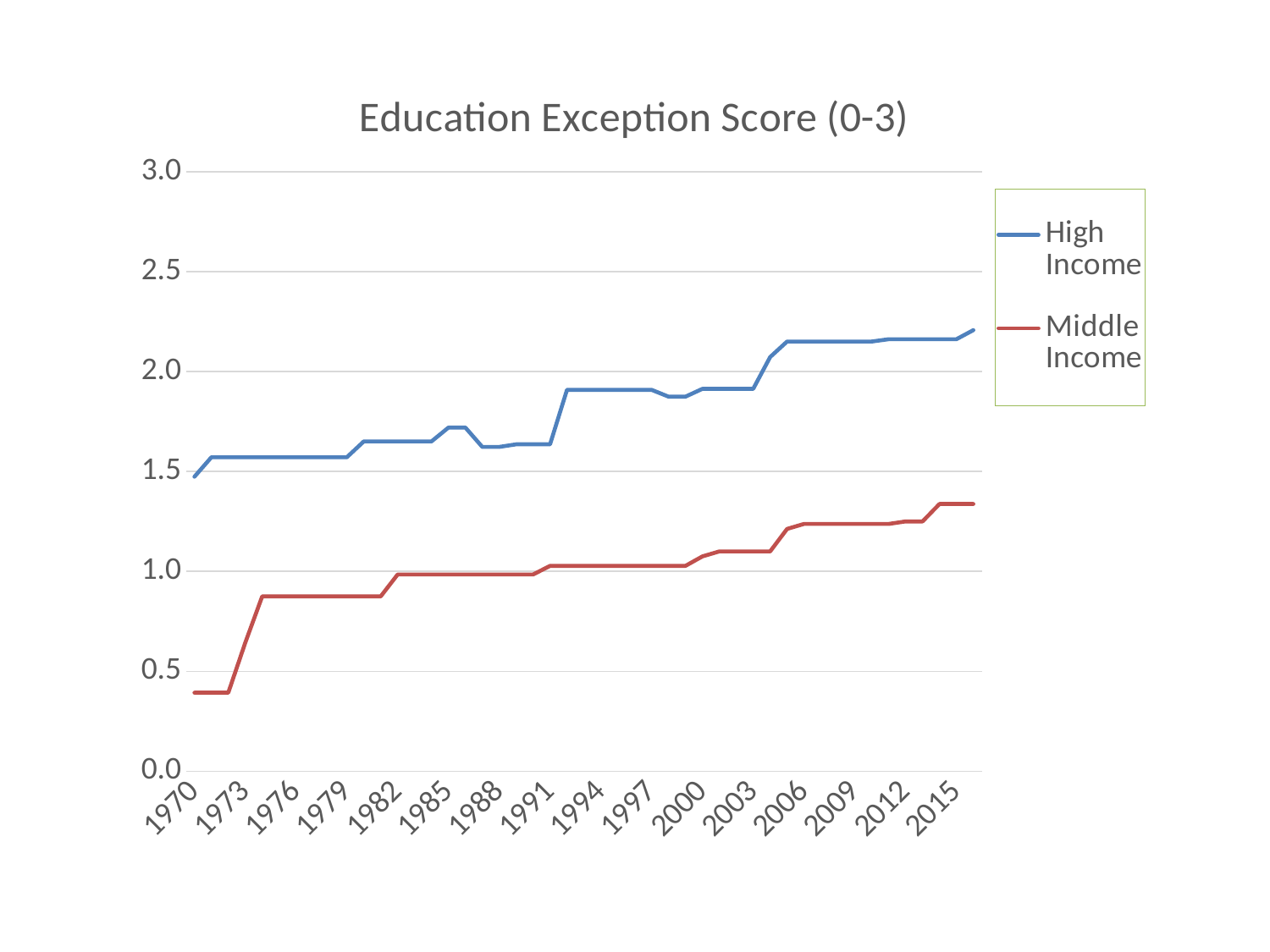
What kind of chart is shown on the slide? line chart Which series has the higher values throughout the chart, High Income or Middle Income? High Income Is the Middle Income value in 1976 greater or less than 1.0? less How many series does the legend list? 2 Is the High Income value in 1991 greater or less than 1.5? greater What is the title of the chart? Education Exception Score (0-3) Do the High Income values generally rise or fall from 1970 to 2015? rise Is the Middle Income value in 1970 greater or less than 0.5? less Do the Middle Income values generally rise or fall from 1970 to 2015? rise Which series is drawn in red? Middle Income